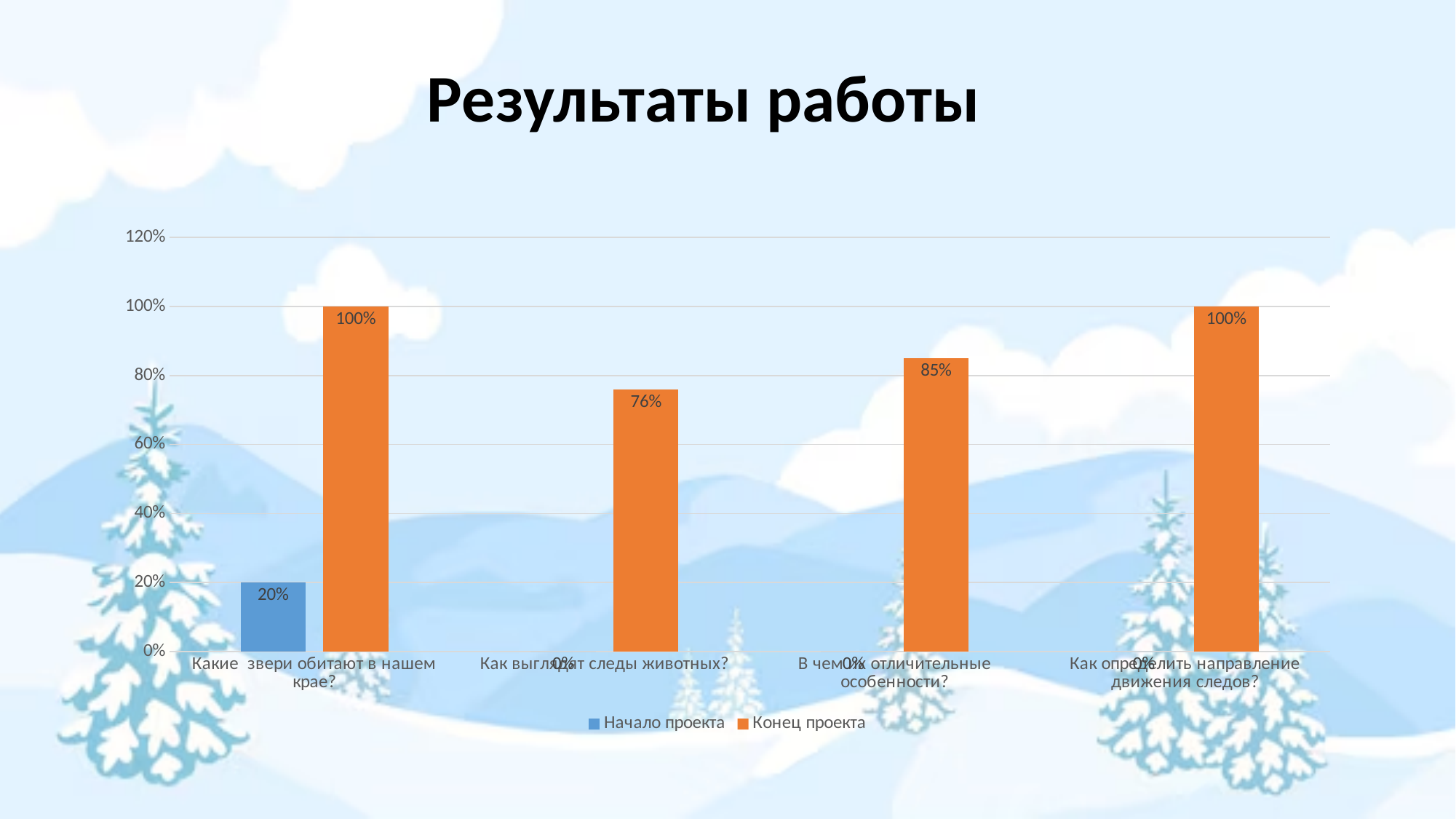
What is the value for "Конец проекта" for the category "В чем их отличительные особенности?"? 85% What is the difference between the "Конец проекта" values for "В чем их отличительные особенности?" and "Как выглядят следы животных?"? 9% How many series does the legend list? 2 What kind of chart is shown on the slide? bar chart What is the value for "Конец проекта" for the category "Какие звери обитают в нашем крае?"? 100% What is the difference between the "Конец проекта" and "Начало проекта" values for "Какие звери обитают в нашем крае?"? 80% Which is larger: the "Конец проекта" value for "Как выглядят следы животных?" or for "В чем их отличительные особенности?"? В чем их отличительные особенности? How many categories are shown on the x axis? 4 What is the value for "Конец проекта" for the category "Как выглядят следы животных?"? 76% Which category has the lowest "Конец проекта" value? Как выглядят следы животных? What is the title of the slide? Результаты работы What is the value for "Начало проекта" for the category "Какие звери обитают в нашем крае?"? 20%